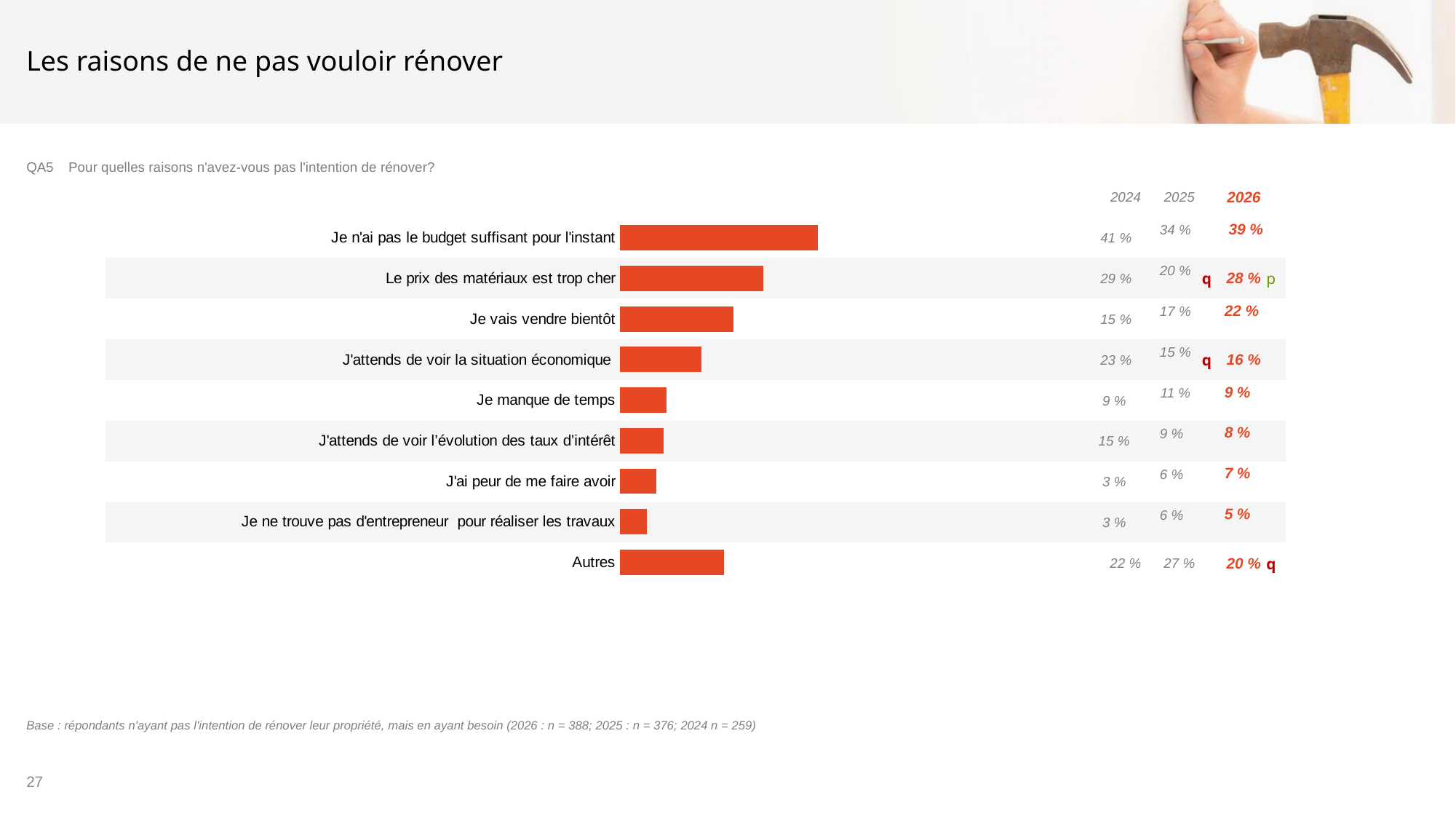
Which reason has the lowest 2026 value? Je ne trouve pas d'entrepreneur pour réaliser les travaux What kind of chart is shown on the slide? Bar chart How many years of data are listed in the column headers? 3 What is the 2024 value for "J'attends de voir la situation économique"? 23 % What is the 2026 value for "Je n'ai pas le budget suffisant pour l'instant"? 39 % What is the title of the slide? Les raisons de ne pas vouloir rénover What is the 2025 value for "Autres"? 27 % What is the difference between the 2026 and 2025 values for "Le prix des matériaux est trop cher"? 8 % Which is larger for "Je vais vendre bientôt": the 2024 value or the 2026 value? 2026 What is the difference between the 2024 and 2026 values for "J'attends de voir l'évolution des taux d'intérêt"? 7 % Which reason has the highest 2026 value? Je n'ai pas le budget suffisant pour l'instant How many reasons (categories) are shown in the chart? 9